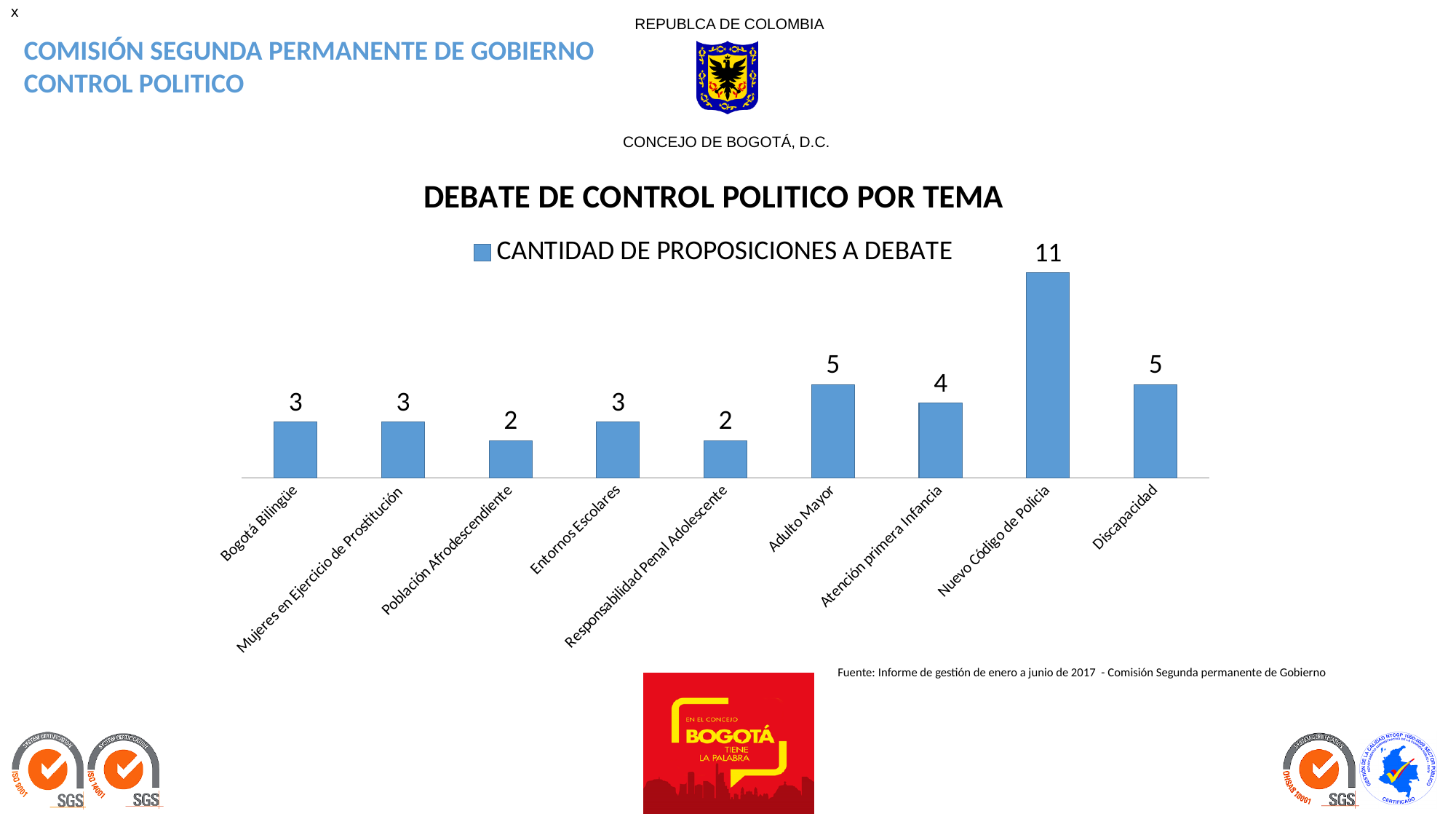
Which is larger, the value for Adulto Mayor or the value for Atención primera Infancia? Adulto Mayor What is the value for Atención primera Infancia? 4 What is the value for Población Afrodescendiente? 2 Which category has the highest value? Nuevo Código de Policia How many categories are shown on the x axis? 9 What is the title of the chart? DEBATE DE CONTROL POLITICO POR TEMA What is the name of the series in the legend? CANTIDAD DE PROPOSICIONES A DEBATE What is the value for Adulto Mayor? 5 What kind of chart is shown? bar chart What is the value for Nuevo Código de Policia? 11 What is the difference between the values for Nuevo Código de Policia and Discapacidad? 6 How many series does the legend list? 1